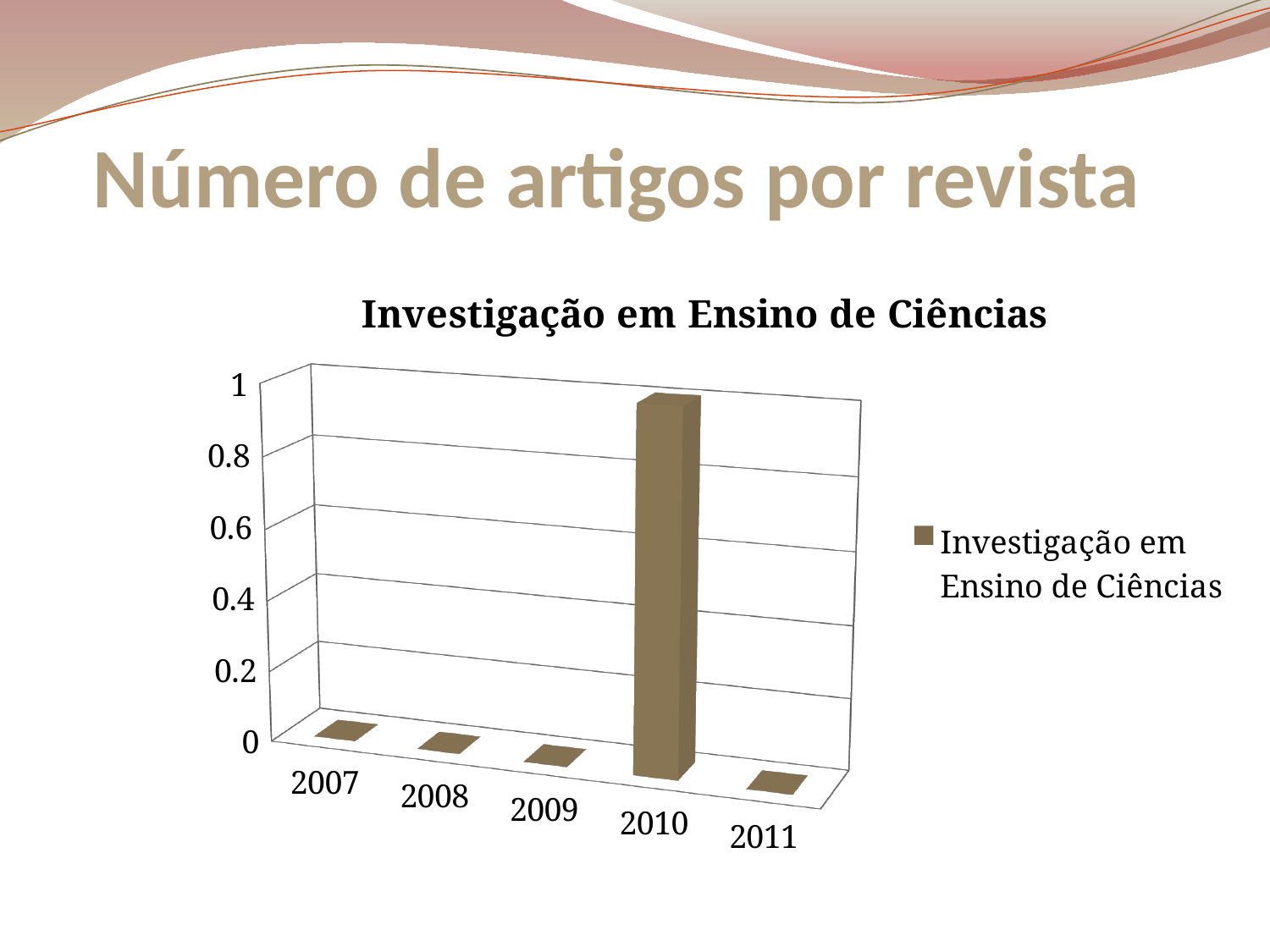
What is the value for 2011 in the chart? 0 What type of chart is shown on the slide? bar chart What is the title of the chart? Investigação em Ensino de Ciências Which is larger, the value for 2010 or the value for 2008? 2010 How many series does the chart legend list? 1 What is the name of the series shown in the legend? Investigação em Ensino de Ciências What is the value for 2007 in the chart? 0 What is the value for 2010 in the chart? 1 Is the value for 2009 greater or less than 0.2? less Is the value for 2010 greater or less than 0.8? greater Which year has the highest value in the chart? 2010 How many years are shown on the x axis of the chart? 5